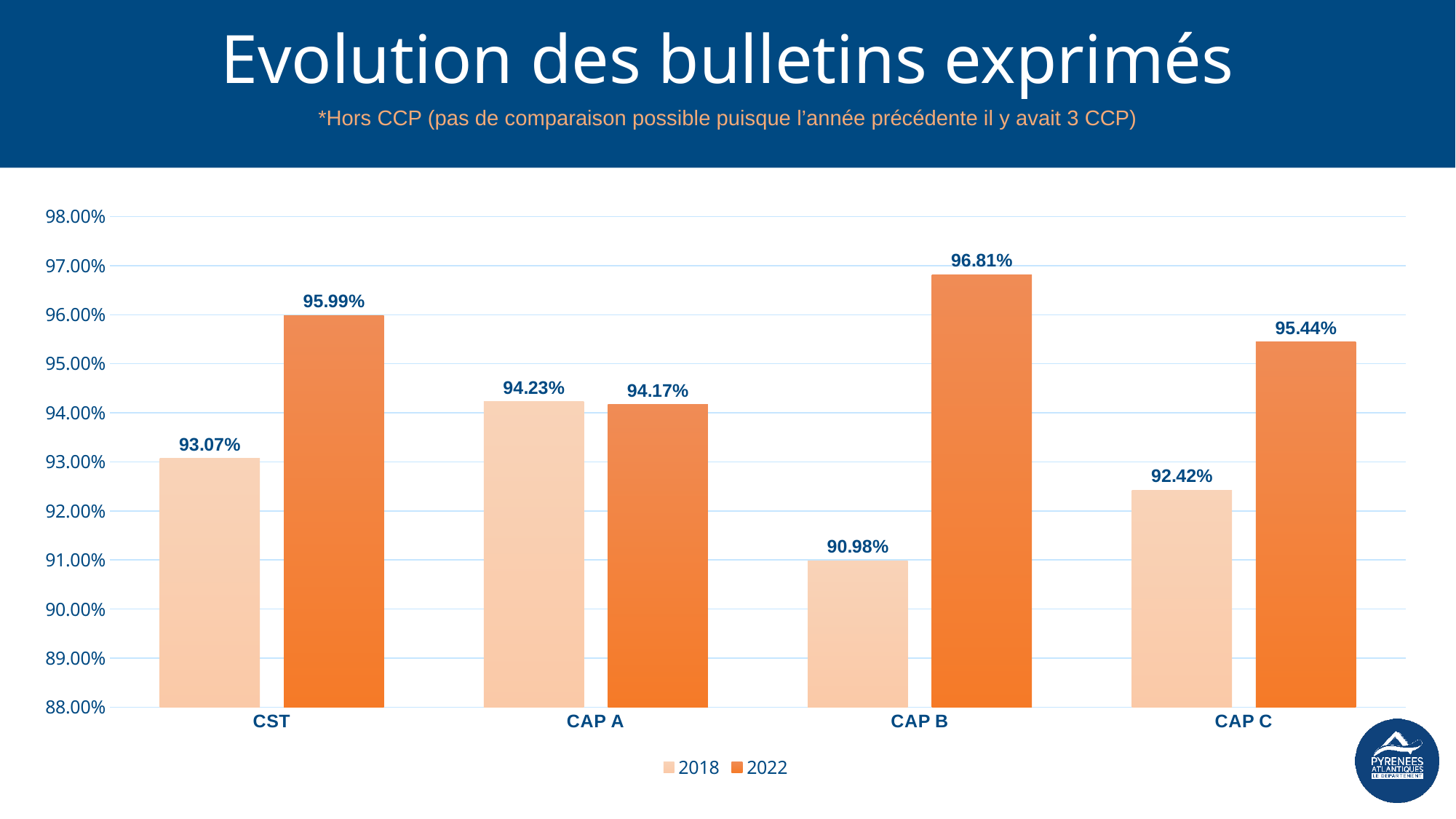
How many categories are shown on the x axis? 4 Which category has the lowest 2018 value? CAP B Which category has the highest 2022 value? CAP B What is the 2018 value for CAP C? 92.42% Which is larger for CAP C, the 2018 value or the 2022 value? 2022 What is the 2022 value for CAP B? 96.81% What is the 2018 value for CST? 93.07% What is the difference between the 2022 and 2018 values for CAP B? 5.83% What kind of chart is shown on the slide? Bar chart What is the title of the chart on the slide? Evolution des bulletins exprimés What is the difference between the 2022 and 2018 values for CST? 2.92% How many series does the legend list? 2